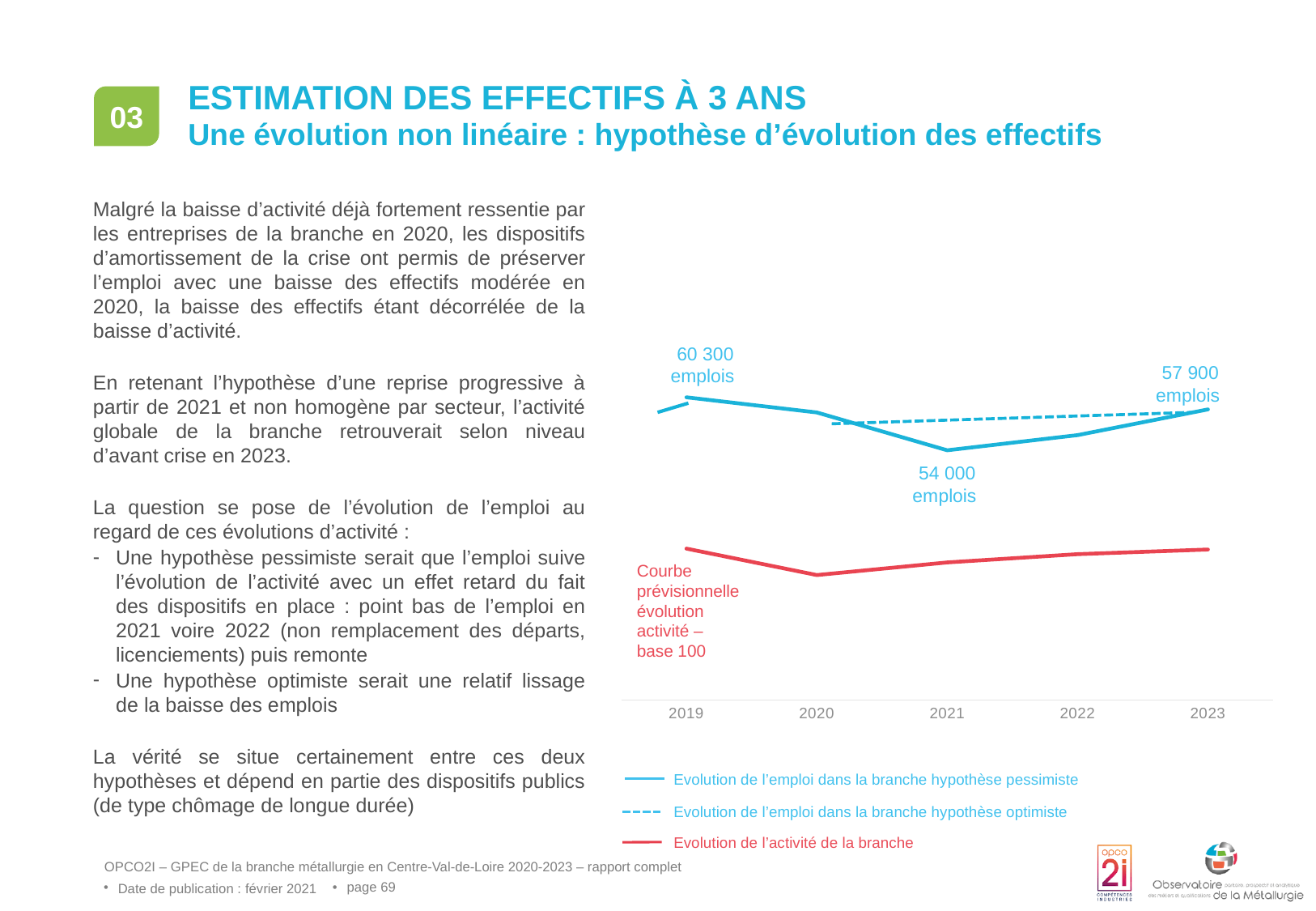
What is the difference between the 2019 employment value (60 300) and the 2023 value (57 900) on the pessimistic line? 2 400 What is the employment value labelled for 2023 on the pessimistic hypothesis line? 57 900 emplois What type of chart is shown on the slide? line chart Which year has the higher employment value on the pessimistic line, 2019 or 2023? 2019 What is the employment value labelled for 2019 on the pessimistic hypothesis line? 60 300 emplois Does the pessimistic employment line rise or fall between 2021 and 2023? rise What is the difference between the 2019 employment value (60 300) and the 2021 low point (54 000) on the pessimistic line? 6 300 What is the employment value labelled at the low point of the pessimistic hypothesis line in 2021? 54 000 emplois In which year does the pessimistic employment line reach its lowest point? 2021 Which series is drawn as a dashed line in the chart? Evolution de l'emploi dans la branche hypothèse optimiste How many years are shown on the x axis of the chart? 5 How many series does the chart legend list? 3